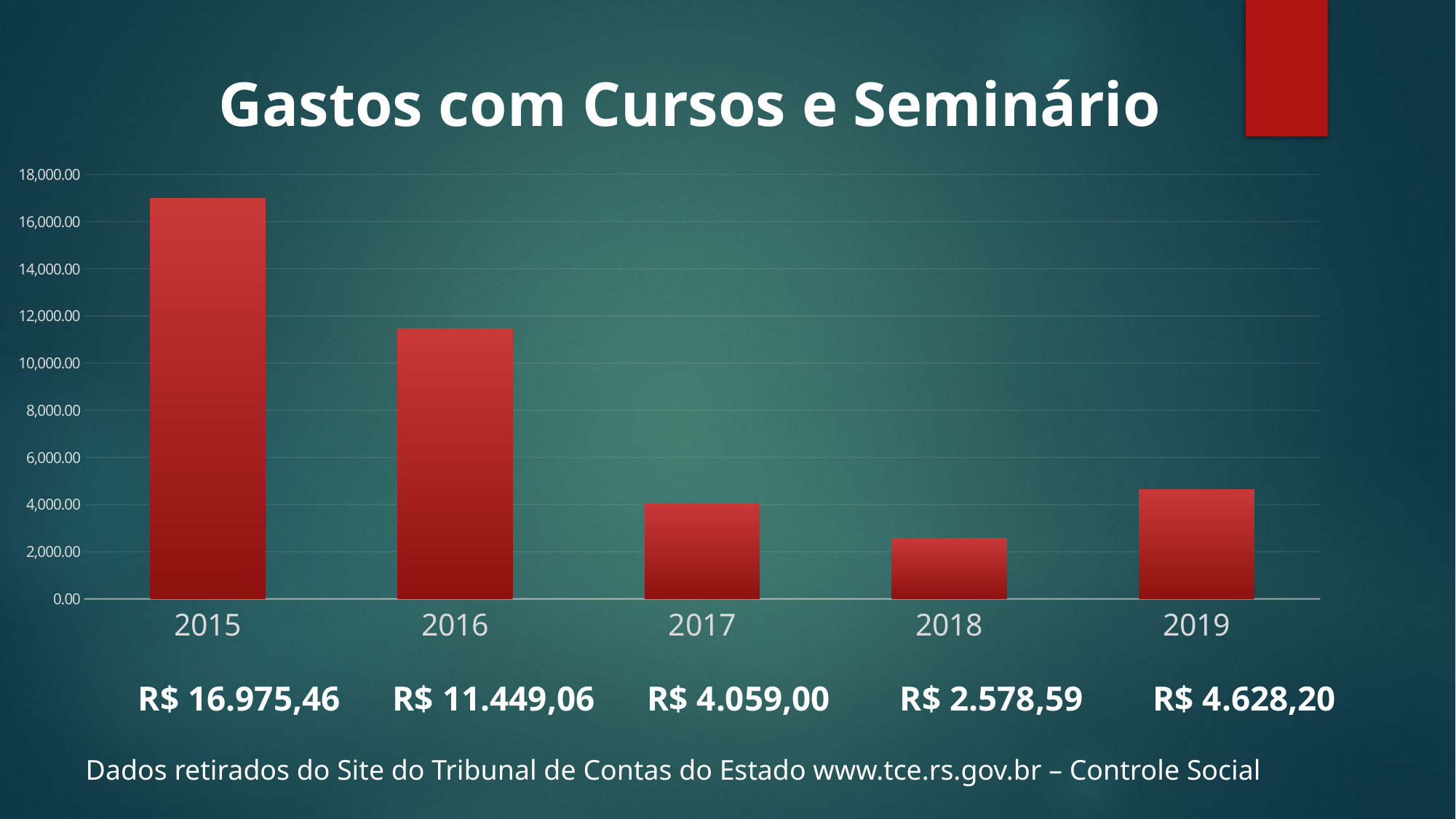
What is the difference between the values for 2019 and 2017? R$ 569,20 Which year has the highest spending? 2015 What is the value for 2015? R$ 16.975,46 Which is larger, the value for 2017 or the value for 2019? 2019 What is the value for 2018? R$ 2.578,59 Is the value for 2016 greater or less than 10,000.00? greater Which year has the lowest spending? 2018 Do the values rise or fall from 2015 to 2018? fall How many years are shown on the x axis? 5 What is the value for 2019? R$ 4.628,20 What kind of chart is shown on the slide? bar chart What is the difference between the values for 2015 and 2016? R$ 5.526,40